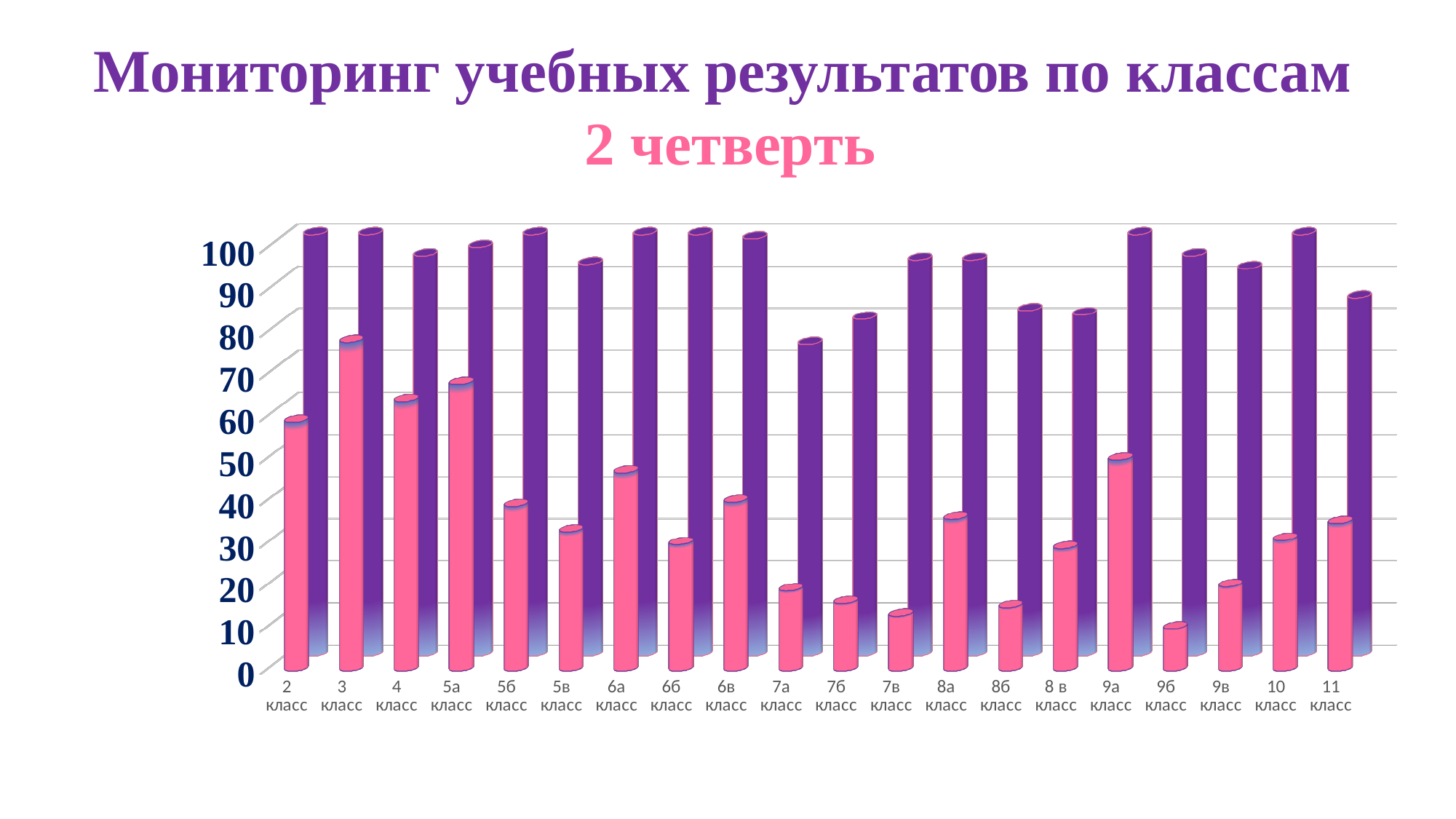
Which class has the lowest value in the purple series? 7а класс Which class has the lowest value in the pink series? 9б класс What is the title of the chart on the slide? Мониторинг учебных результатов по классам 2 четверть How many data series are plotted in the chart? 2 Is the purple-series value for 7а класс greater or less than 80? less Which class has the highest value in the pink series? 3 класс Is the pink-series value for 3 класс greater or less than 70? greater Is the pink-series value for 2 класс greater or less than 50? greater How many classes (categories) are shown along the x axis? 20 What kind of chart is shown on the slide? bar chart In the pink series, which is larger: the value for 8а класс or for 8б класс? 8а класс